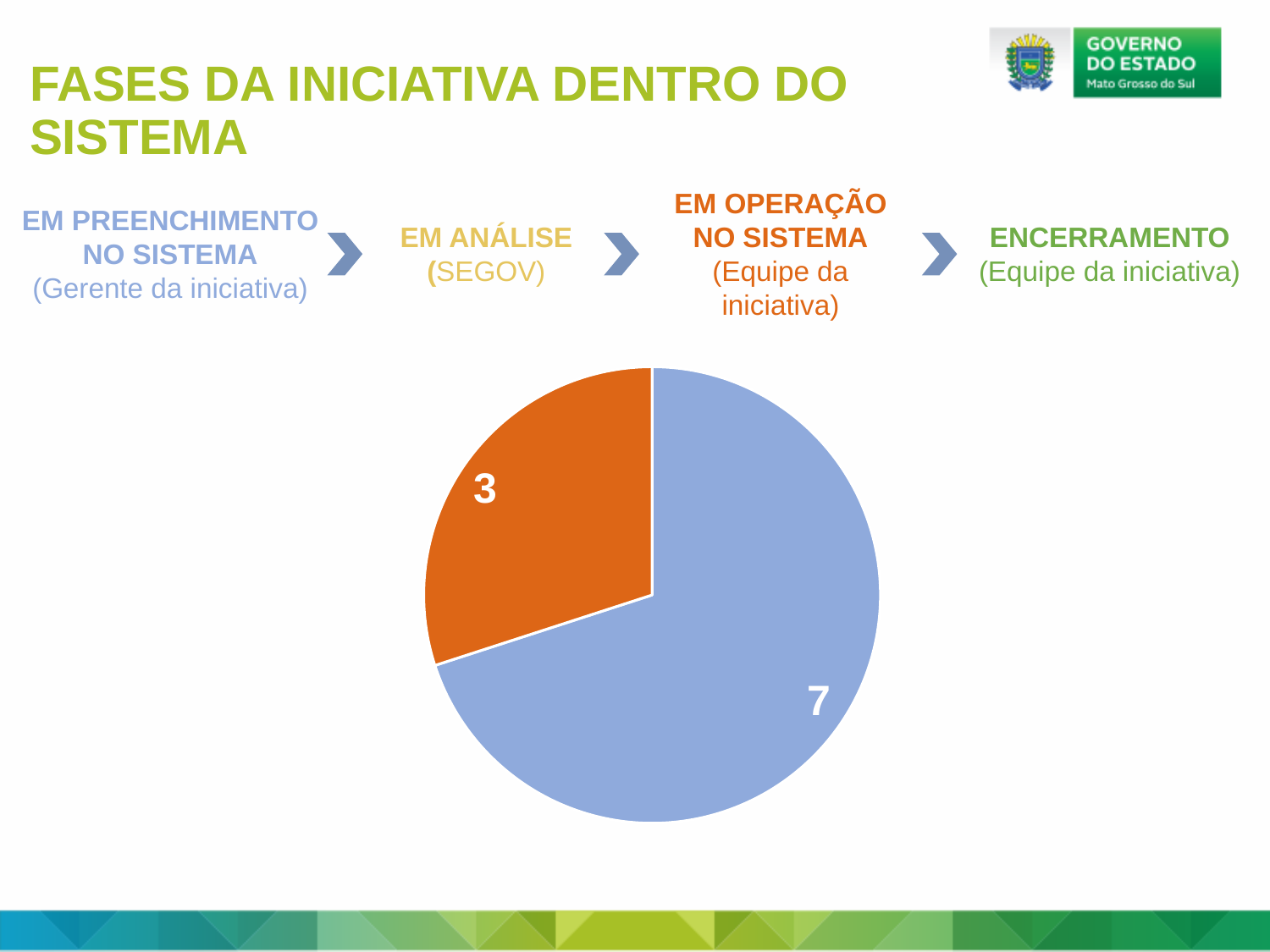
Does the pie chart display a legend? No What value is shown on the orange slice of the pie chart? 3 What value is shown on the blue slice of the pie chart? 7 What kind of chart is shown on the slide? pie chart What share of the pie does the blue slice represent? 70% Is the blue slice or the orange slice larger in the pie chart? the blue slice What share of the pie does the orange slice represent? 30% What is the total of the values shown on the pie chart? 10 Which slice of the pie chart has the smallest value? the orange slice (3) How many slices does the pie chart have? 2 What is the difference between the blue slice value and the orange slice value in the pie chart? 4 Which slice of the pie chart has the largest value? the blue slice (7)